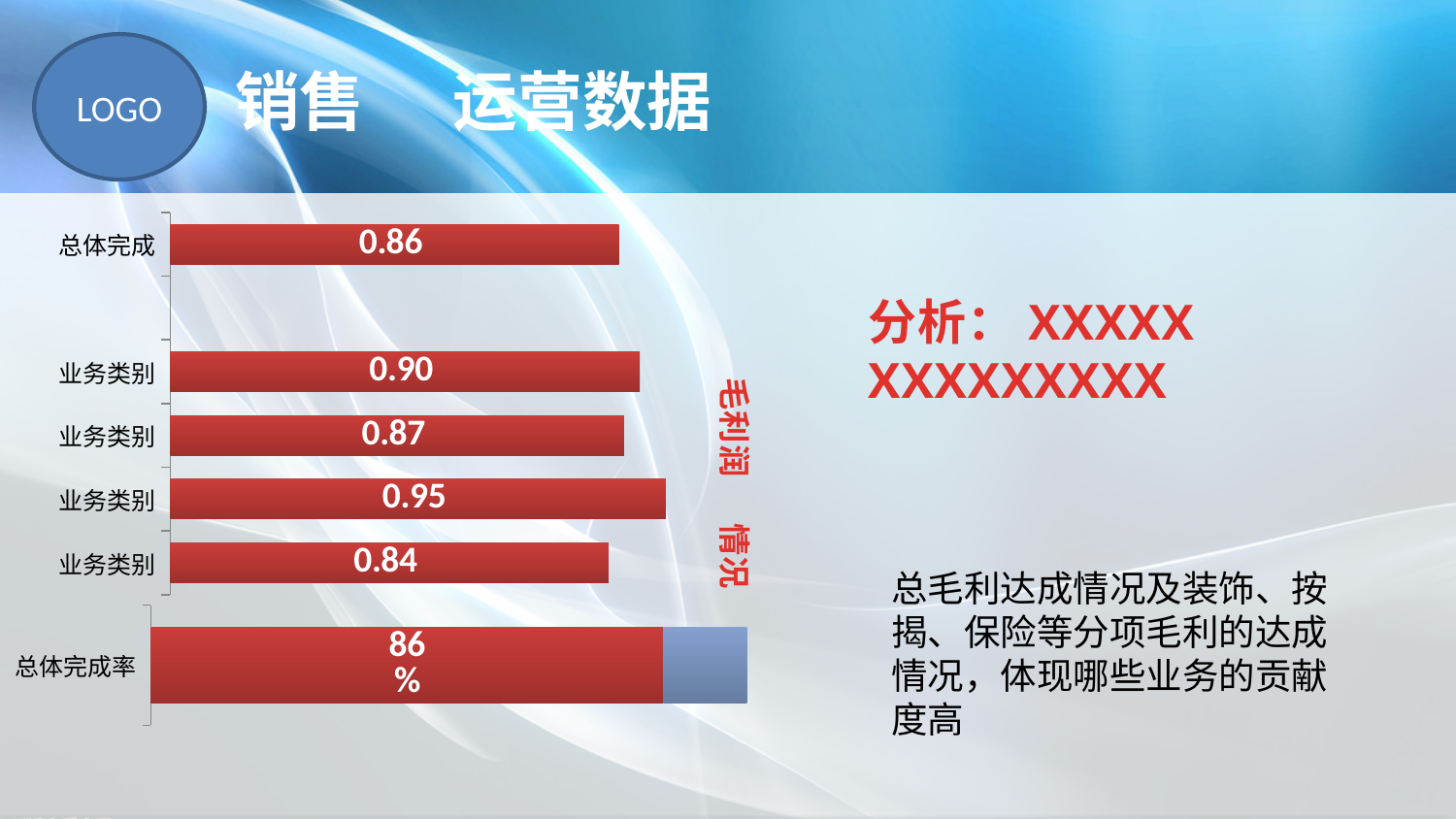
In the upper bar chart, which is larger: the 总体完成 bar or the second bar from the top? the second bar from the top (0.90) In the lower bar, what is the value shown for 总体完成率? 86% What is the vertical title written beside the bar chart? 毛利润 情况 In the upper bar chart, what is the value of the bottom bar (the last 业务类别 bar)? 0.84 In the upper bar chart, what is the value for 总体完成? 0.86 How many bars are in the upper bar chart? 5 In the upper bar chart, what is the value of the second bar from the top (the first 业务类别 bar)? 0.90 In the upper bar chart, what is the highest value shown among the five bars? 0.95 In the upper bar chart, what is the difference between the second bar from the top (0.90) and the 总体完成 bar (0.86)? 0.04 In the upper bar chart, what is the difference between the highest value (0.95) and the lowest value (0.84)? 0.11 In the upper bar chart, what is the lowest value shown among the five bars? 0.84 What kind of chart is shown on the left of the slide? bar chart